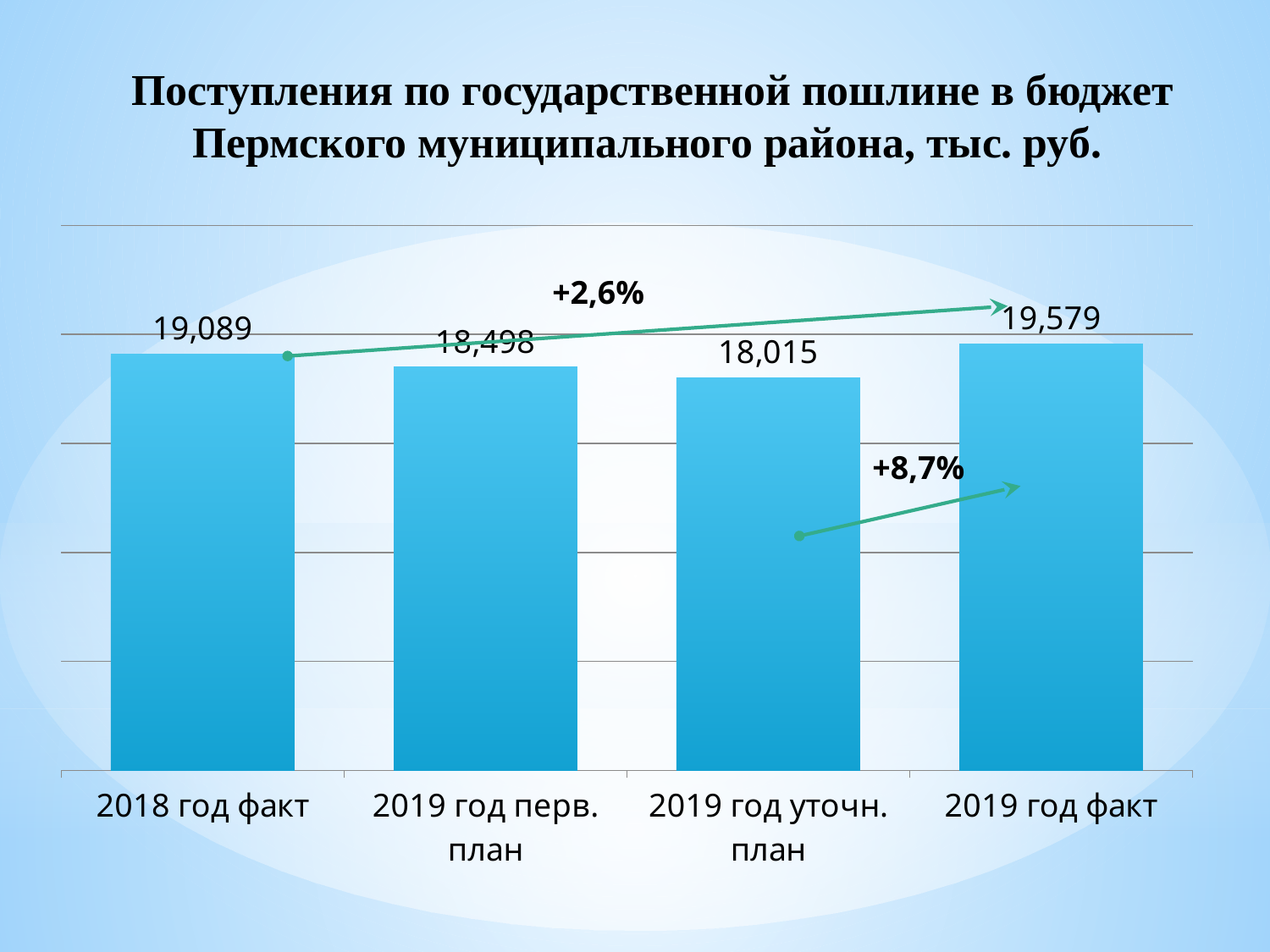
How many categories are shown on the chart? 4 Which is larger, the value for 2018 год факт or the value for 2019 год перв. план? 2018 год факт What is the value for 2019 год перв. план? 18,498 What is the difference between the values for 2019 год факт and 2018 год факт? 490 What percentage change is annotated between 2019 год уточн. план and 2019 год факт? +8,7% What is the value for 2018 год факт? 19,089 Which category has the lowest value? 2019 год уточн. план What kind of chart is shown on the slide? bar chart What is the difference between the values for 2019 год факт and 2019 год уточн. план? 1,564 What is the value for 2019 год уточн. план? 18,015 Which category has the highest value? 2019 год факт What is the value for 2019 год факт? 19,579